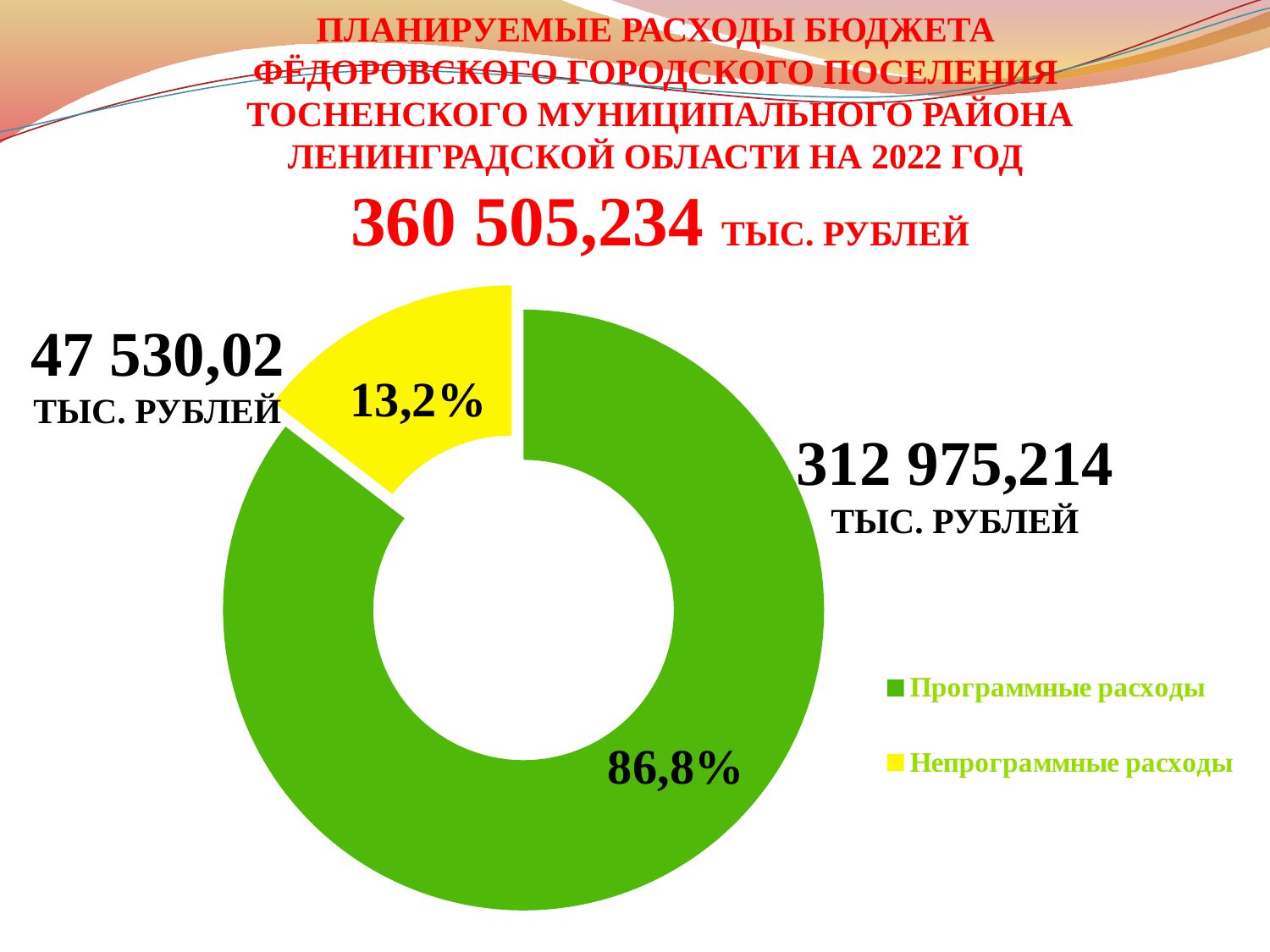
What is the value shown for Непрограммные расходы in тыс. рублей? 47 530,02 What colour represents Непрограммные расходы in the chart? Yellow Which is larger, Программные расходы or Непрограммные расходы? Программные расходы What total planned expenditure is stated above the chart, in тыс. рублей? 360 505,234 How many categories does the chart show? 2 What is the difference in percentage points between the shares of Программные расходы and Непрограммные расходы? 73,6 What share of the chart does Непрограммные расходы take? 13,2% What is the value shown for Программные расходы in тыс. рублей? 312 975,214 Which category has the largest share of the chart? Программные расходы What kind of chart is shown on the slide? Doughnut (pie) chart Which category has the smallest share of the chart? Непрограммные расходы What share of the chart does Программные расходы take? 86,8%